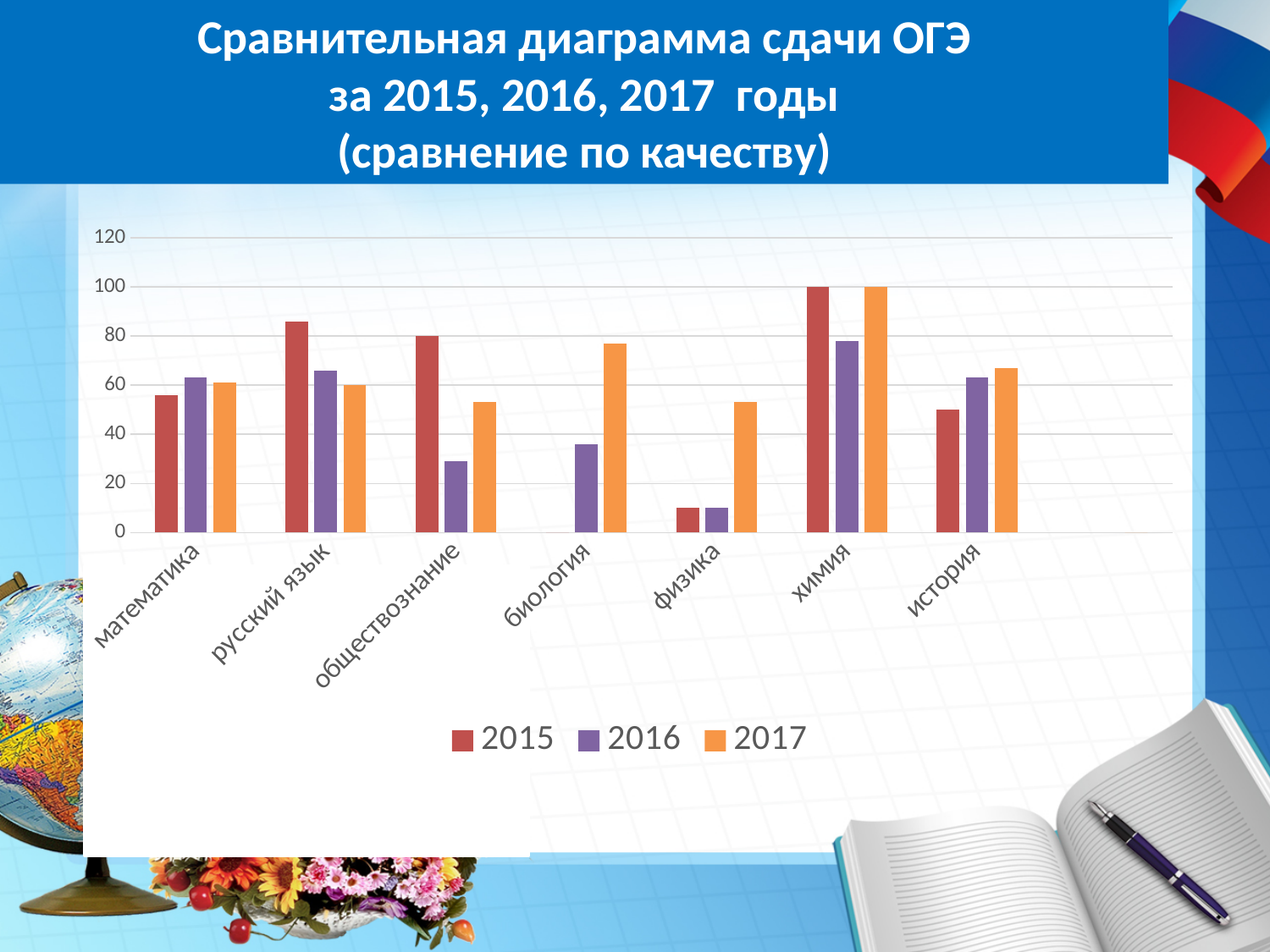
What is the value for химия in 2015? 100 Which years are listed in the legend? 2015, 2016, 2017 Is the value for обществознание in 2016 greater or less than 40? less Which subject has the highest value for 2016? химия How many subjects (categories) are shown on the x axis? 7 Which is larger for обществознание: the 2015 value or the 2017 value? 2015 How many series does the legend list? 3 Is the value for русский язык in 2015 greater or less than 80? greater What kind of chart is shown on the slide? bar chart Which is larger for биология: the 2016 value or the 2017 value? 2017 Do the values for русский язык rise or fall from 2015 to 2017? fall